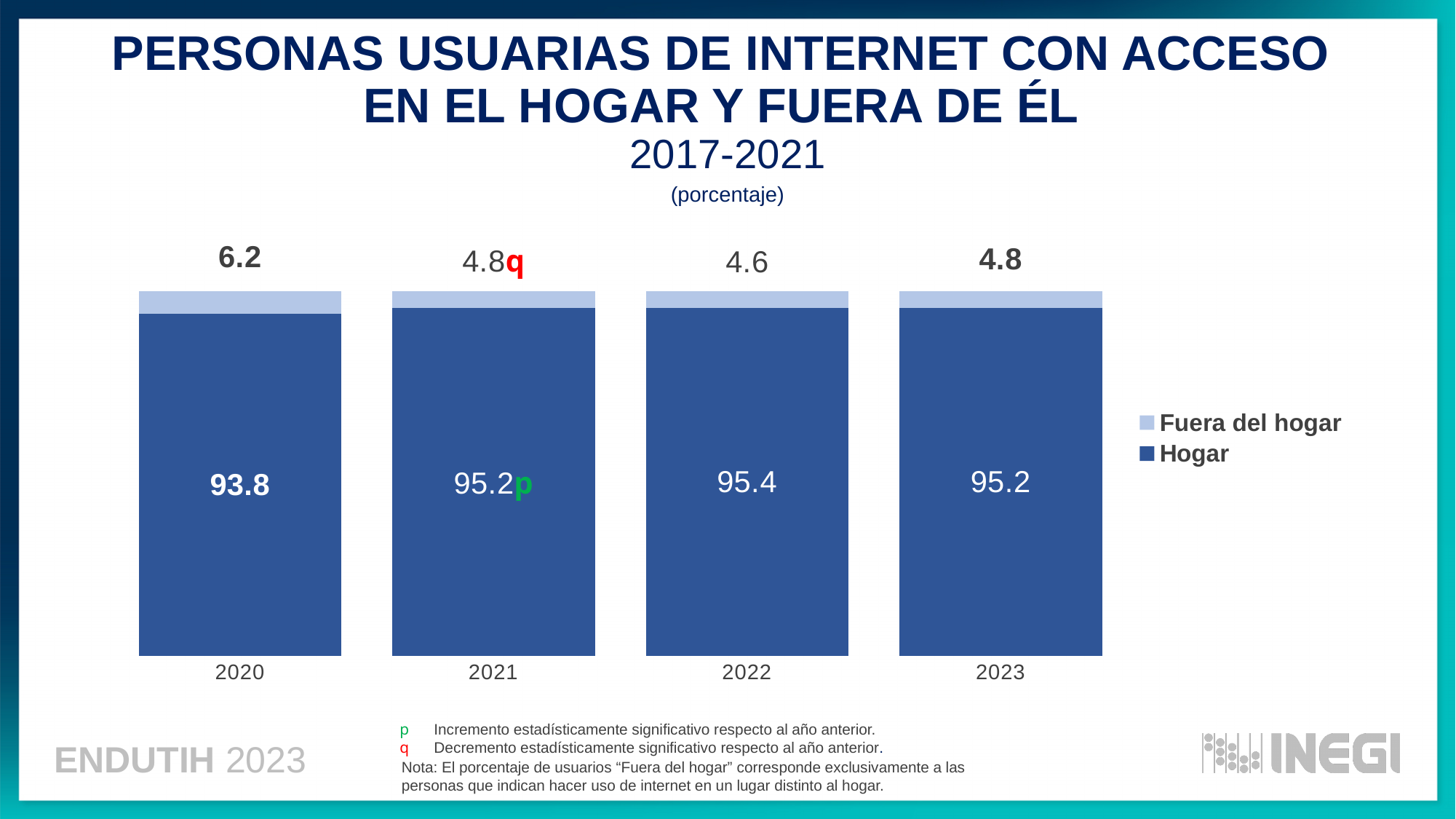
What kind of chart is shown on the slide? Stacked bar chart Which year has the highest Hogar value? 2022 What is the Hogar value for 2020? 93.8 Which year has the lowest Hogar value? 2020 How many series does the legend list? 2 What is the Fuera del hogar value for 2020? 6.2 What is the Fuera del hogar value for 2022? 4.6 Which year has the highest Fuera del hogar value? 2020 Is the Fuera del hogar value larger in 2020 or in 2023? 2020 What is the difference between the Hogar values for 2021 and 2020? 1.4 What is the Hogar value for 2023? 95.2 How many years are shown on the x axis? 4